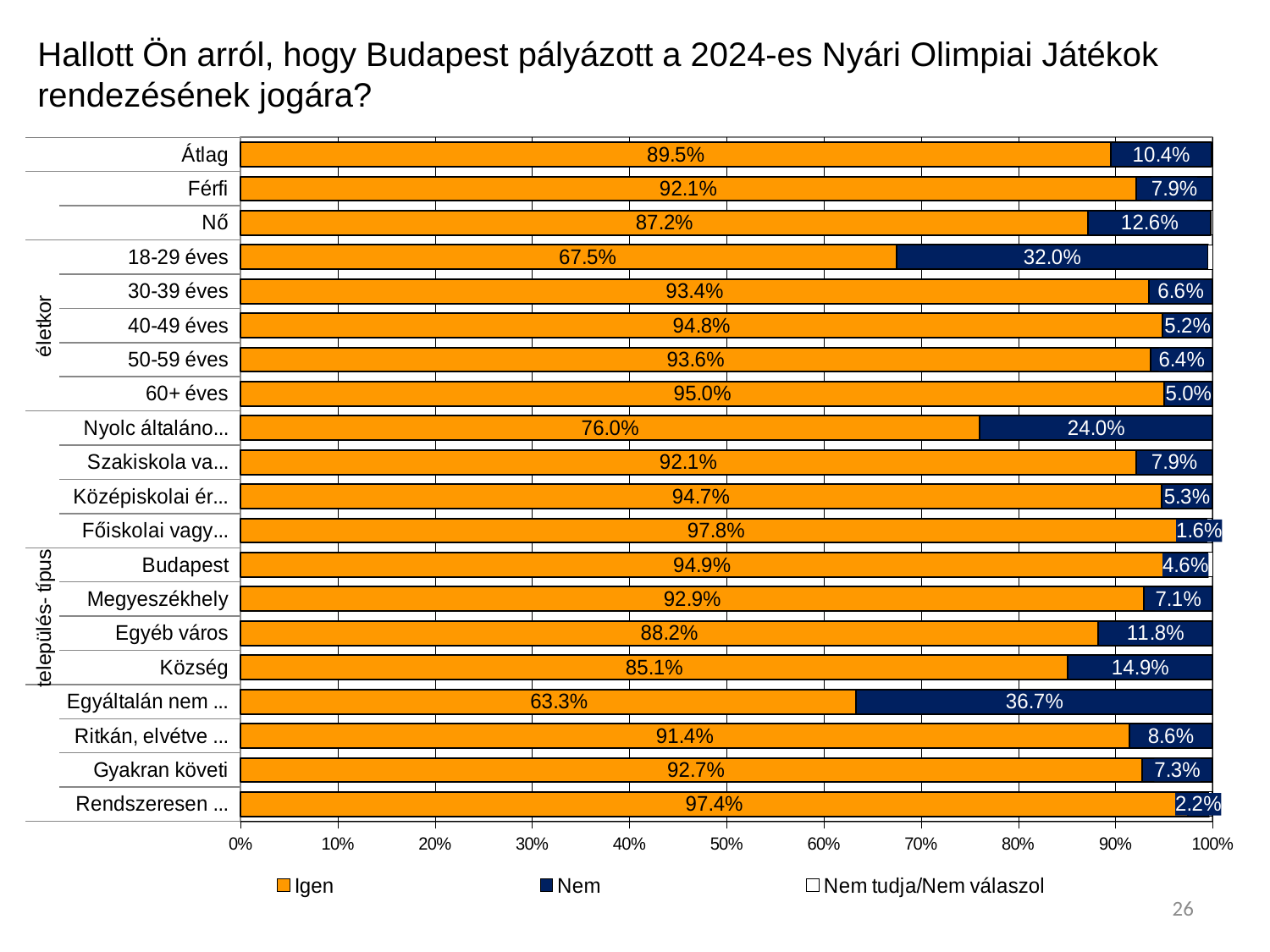
What kind of chart is shown on the slide? Stacked bar chart Among the settlement types (település-típus), which has the lowest "Igen" share? Község How many categories (rows) are plotted in the chart? 20 Among the age groups (életkor), which has the highest "Igen" share? 60+ éves What is the "Igen" value for Átlag? 89.5% How many series does the legend list? 3 What is the "Nem" value for Egyéb város? 11.8% What is the "Nem" value for the 18-29 éves group? 32.0% Which series is shown in orange according to the legend? Igen What is the "Igen" value for Község? 85.1% How many percentage points higher is the "Igen" value for Férfi than for Nő? 4.9 percentage points Which has a larger "Igen" value, Budapest or Megyeszékhely? Budapest